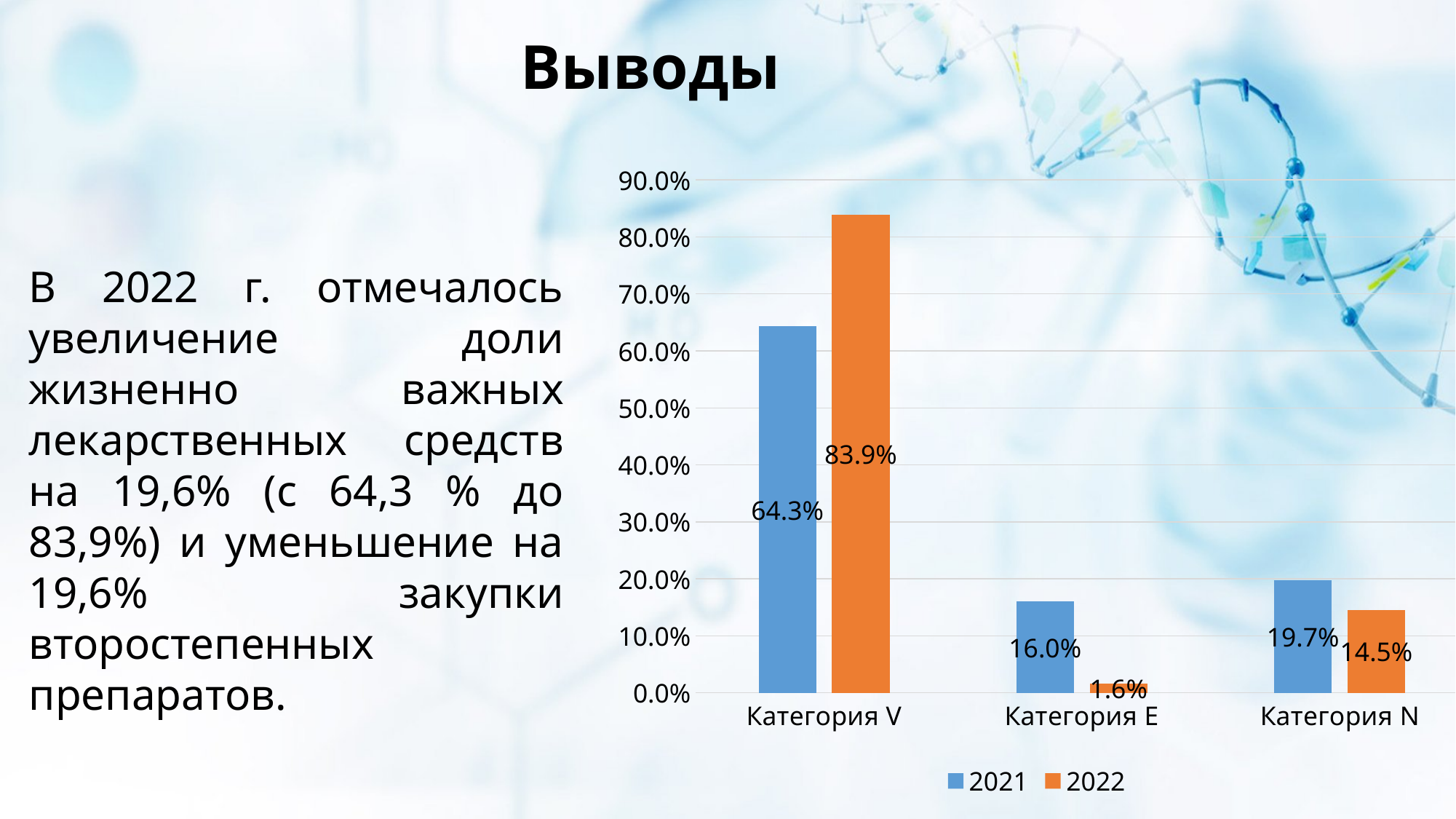
How many categories are shown on the x axis? 3 What is the value for Категория V in the 2022 series? 83.9% Which category has the lowest value in the 2022 series? Категория E Which category has the highest value in the 2022 series? Категория V Which is larger for Категория N: the 2021 value or the 2022 value? 2021 What is the value for Категория V in the 2021 series? 64.3% How many series does the legend list? 2 What is the value for Категория E in the 2021 series? 16.0% What kind of chart is shown on the slide? bar chart What is the value for Категория N in the 2022 series? 14.5% Is the 2021 value for Категория E greater or less than 20.0%? less What is the difference between the 2022 and 2021 values for Категория V? 19.6%